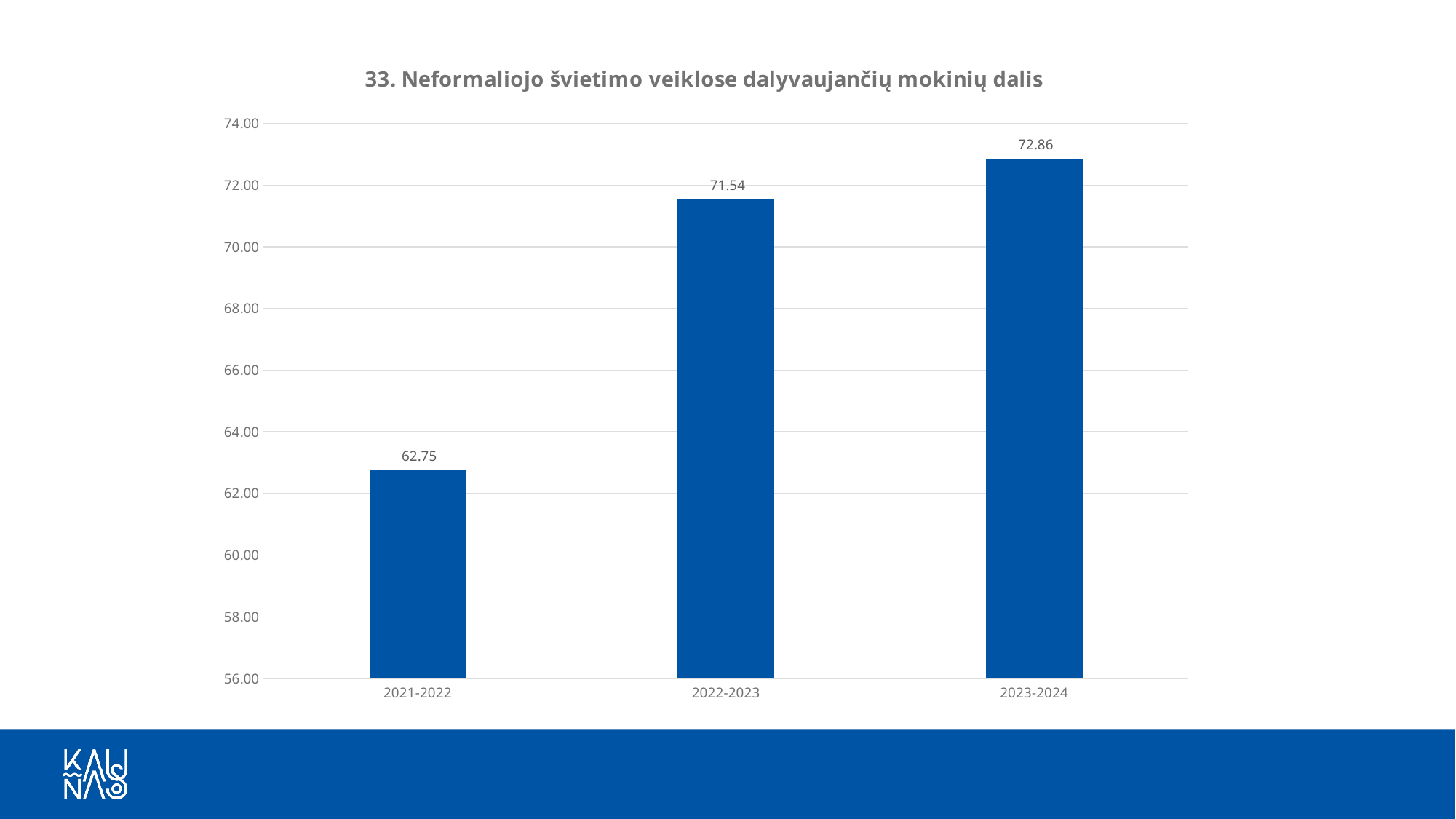
Do the values rise or fall from 2021-2022 to 2023-2024? rise How many school years are shown on the chart? 3 Which school year has the lowest value? 2021-2022 What is the difference between the values for 2023-2024 and 2021-2022? 10.11 Which is larger, the value for 2021-2022 or the value for 2022-2023? 2022-2023 What is the difference between the values for 2022-2023 and 2021-2022? 8.79 Is the value for 2021-2022 greater or less than 64.00? less What is the value for 2021-2022? 62.75 What is the value for 2022-2023? 71.54 Which school year has the highest value? 2023-2024 What kind of chart is shown on the slide? bar chart What is the value for 2023-2024? 72.86